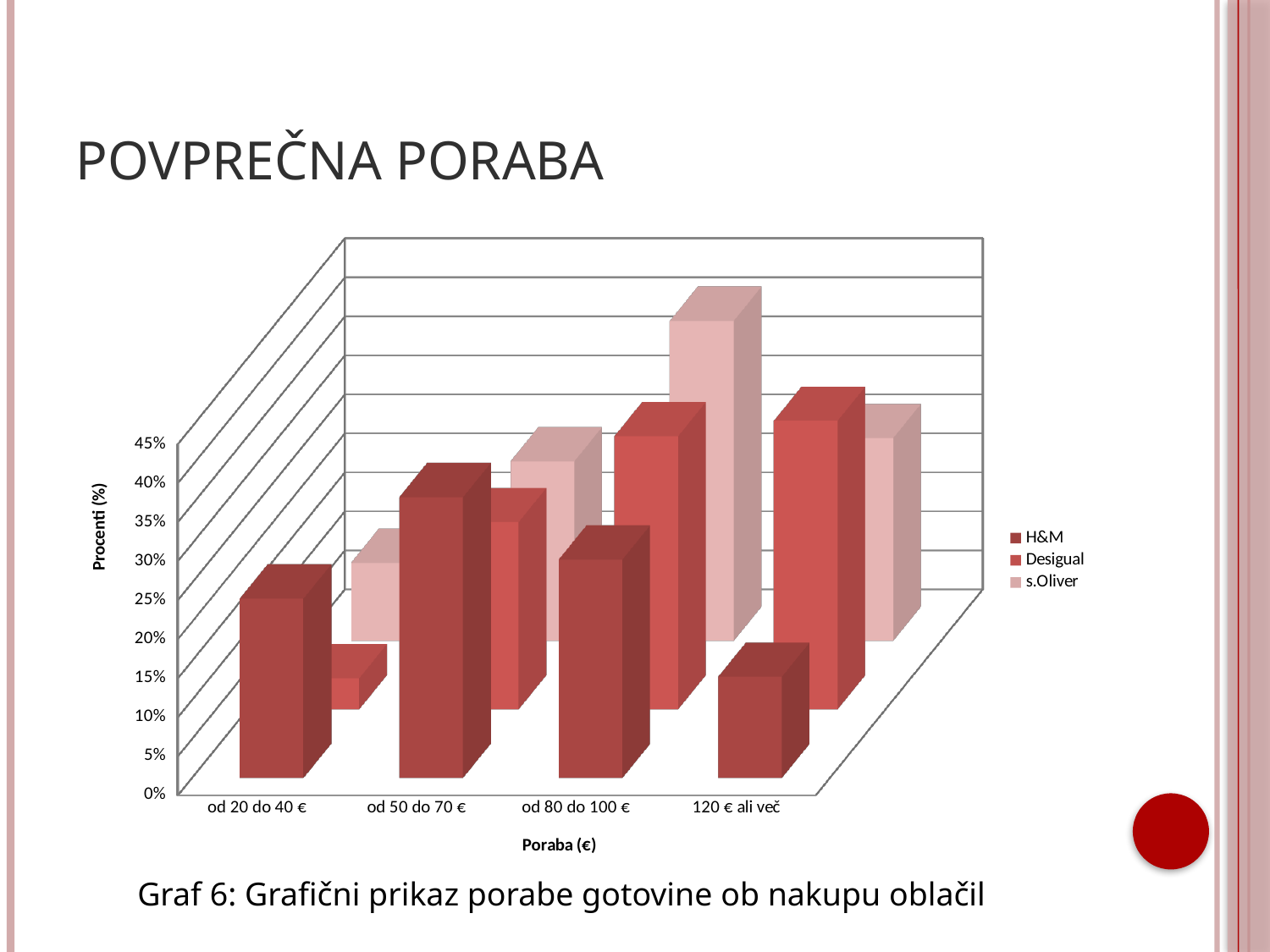
Is the H&M value for 120 € ali več greater or less than 25%? less For the Desigual series, which spending category has the lowest bar? od 20 do 40 € In the od 20 do 40 € category, which is larger: the H&M bar or the Desigual bar? H&M How many spending categories are shown on the x axis? 4 What kind of chart is shown on the slide? bar chart Is the Desigual value for od 20 do 40 € greater or less than 10%? less How many series does the legend list? 3 For the H&M series, which spending category has the lowest bar? 120 € ali več For the H&M series, which spending category has the highest bar? od 50 do 70 € What is the title of the vertical axis? Procenti (%) Which series are listed in the legend? H&M, Desigual, s.Oliver For the s.Oliver series, which spending category has the highest bar? od 80 do 100 €